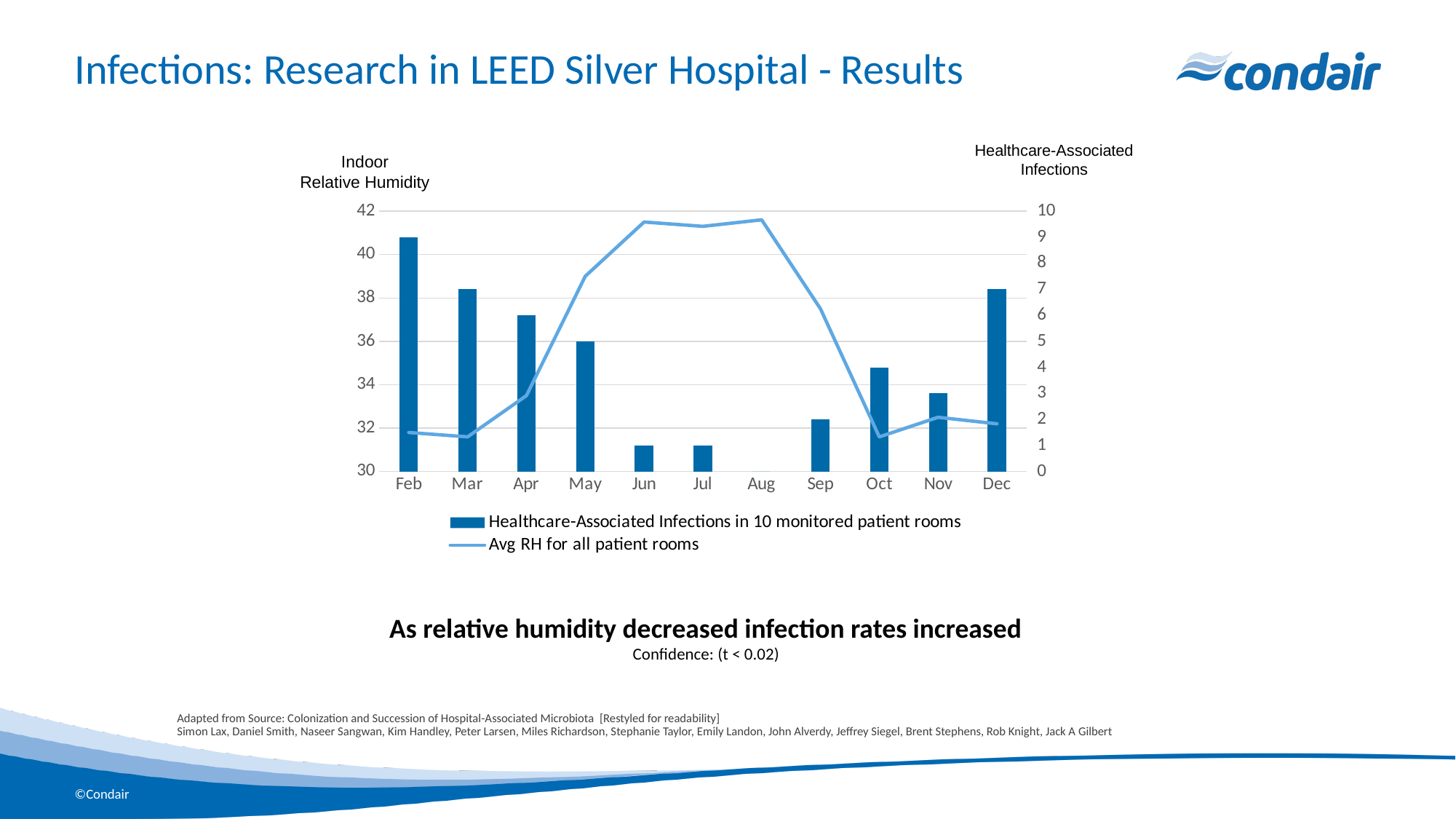
Is the number of Healthcare-Associated Infections in Jun greater or less than 2? less Is the Avg RH for all patient rooms in Jun greater or less than 40? greater Which month has more Healthcare-Associated Infections, Oct or Nov? Oct Is the Avg RH for all patient rooms in Feb greater or less than 34? less Do the Healthcare-Associated Infections rise or fall from Feb to Jun? fall What is the label of the right-hand vertical axis? Healthcare-Associated Infections How many months are shown on the x axis? 11 Which month has a higher Avg RH for all patient rooms, Apr or May? May Which month has the highest number of Healthcare-Associated Infections? Feb How many series does the legend list? 2 What kind of chart is shown on the slide? A combination bar and line chart